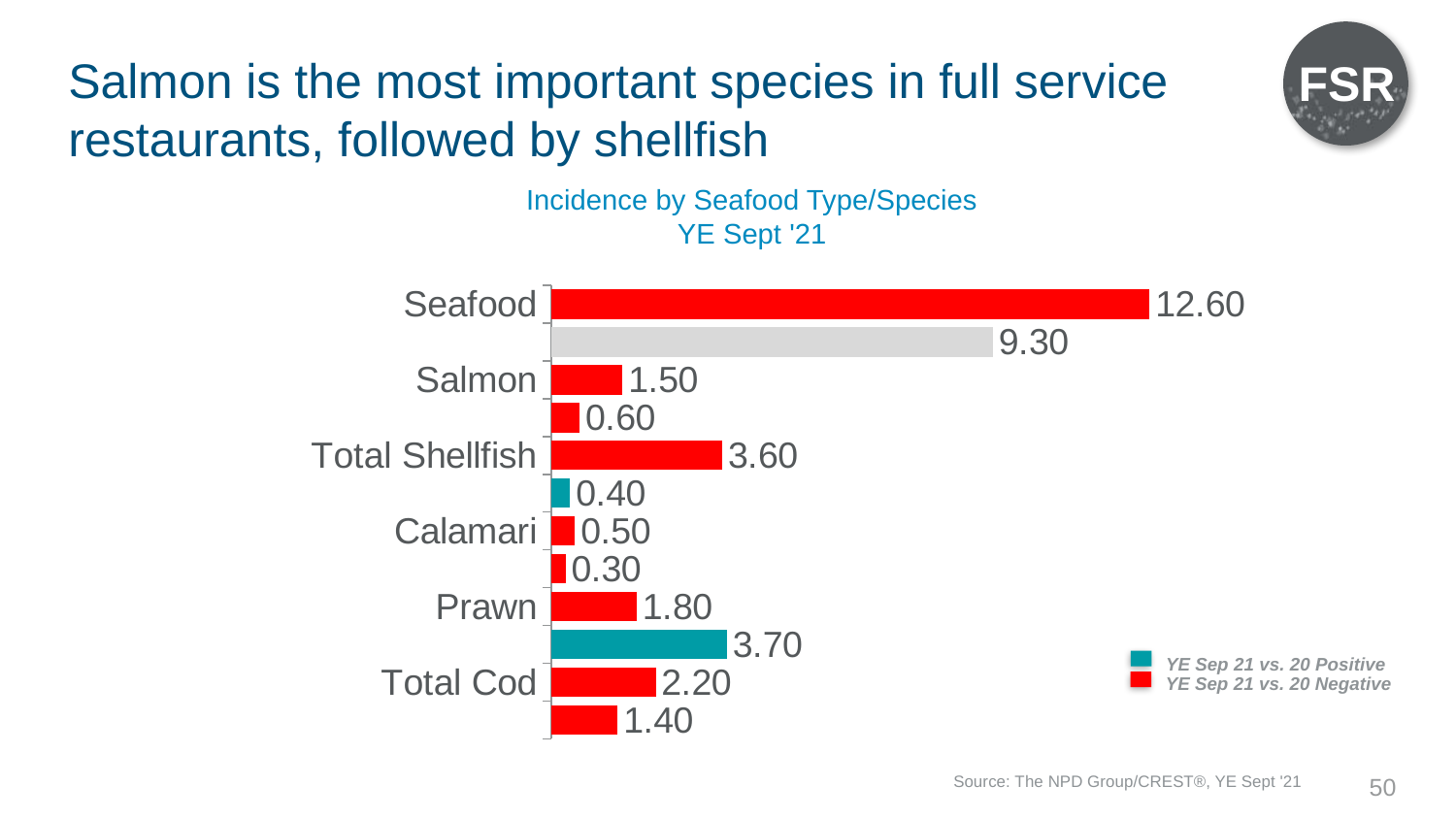
What is the value for Salmon? 1.50 What is the value for Prawn? 1.80 Which is larger, the value for Prawn or the value for Total Cod? Total Cod What kind of chart is shown on the slide? Bar chart What is the value for Seafood? 12.60 What is the value for Total Cod? 2.20 Which labelled category has the highest value? Seafood What is the difference between the values for Total Shellfish and Salmon? 2.10 What is the value for Calamari? 0.50 How many entries does the legend list? 2 Which labelled category has the lowest value? Calamari What is the value for Total Shellfish? 3.60